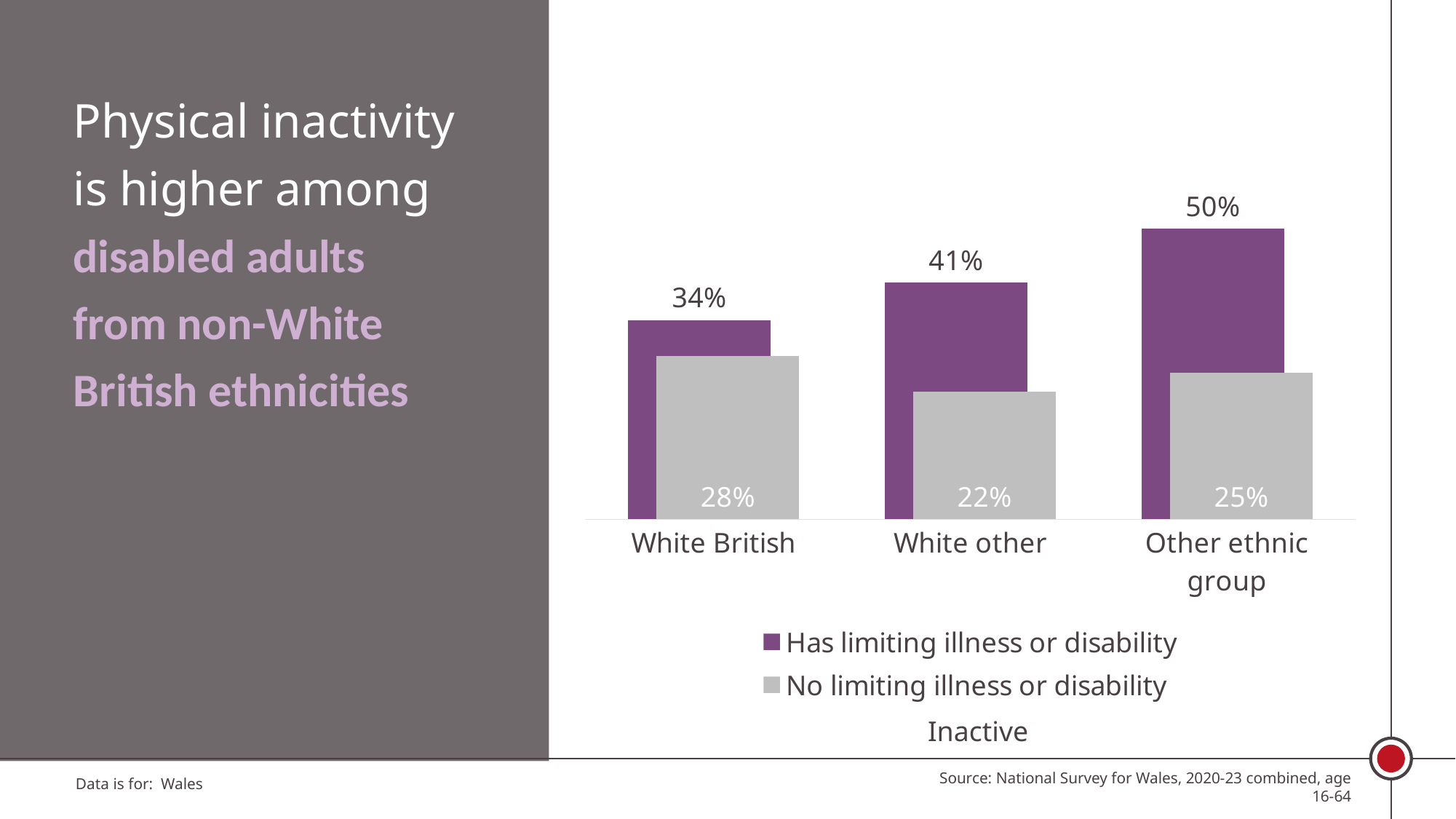
Which colour represents 'Has limiting illness or disability' in the chart? Purple What is the value for White other adults with no limiting illness or disability? 22% Which ethnic group has the lowest inactivity value among those with no limiting illness or disability? White other What is the difference between the 'Has limiting illness or disability' values for White other and White British? 7% What is the difference between the two values for the Other ethnic group? 25% What is the value for the Other ethnic group with a limiting illness or disability? 50% Which ethnic group has the highest inactivity value among those with a limiting illness or disability? Other ethnic group Which is larger: the White British value for 'No limiting illness or disability' or the Other ethnic group value for 'No limiting illness or disability'? White British How many ethnic group categories are shown on the x axis? 3 What is the value for White British adults who have a limiting illness or disability? 34% What kind of chart is shown on the slide? Bar chart How many series does the legend list? 2